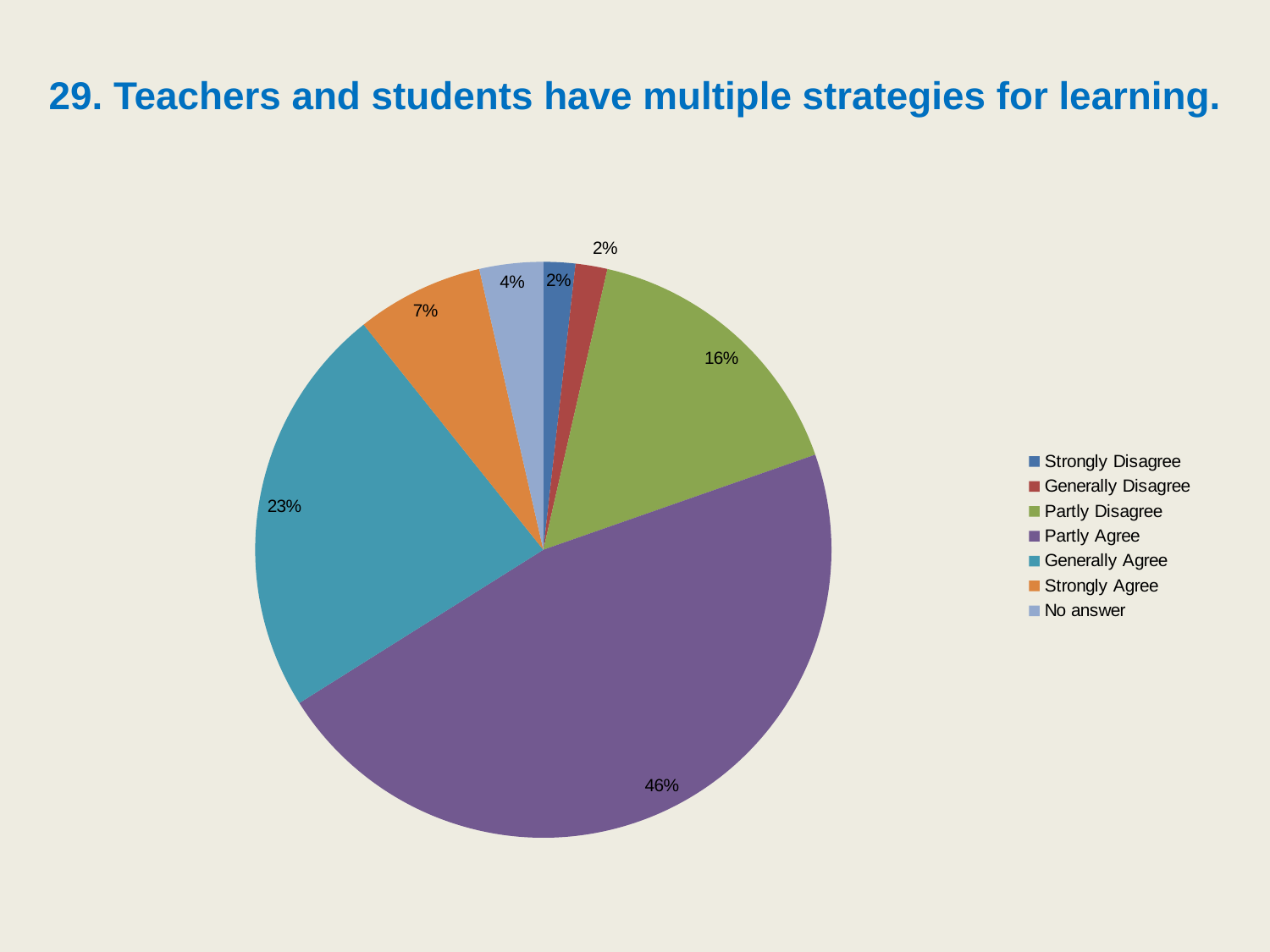
What percentage of respondents chose Strongly Agree? 7% What percentage of respondents chose Partly Disagree? 16% Which is larger, the share for Partly Disagree or the share for Strongly Agree? Partly Disagree What percentage of respondents chose Partly Agree? 46% What kind of chart is shown on the slide? pie chart What percentage of respondents gave No answer? 4% How many response categories does the legend list? 7 What percentage of respondents chose Generally Agree? 23% What is the title of the chart? 29. Teachers and students have multiple strategies for learning. Which response category has the largest share of the pie? Partly Agree What colour is the Partly Agree slice? purple What is the difference in percentage points between Partly Agree and Generally Agree? 23